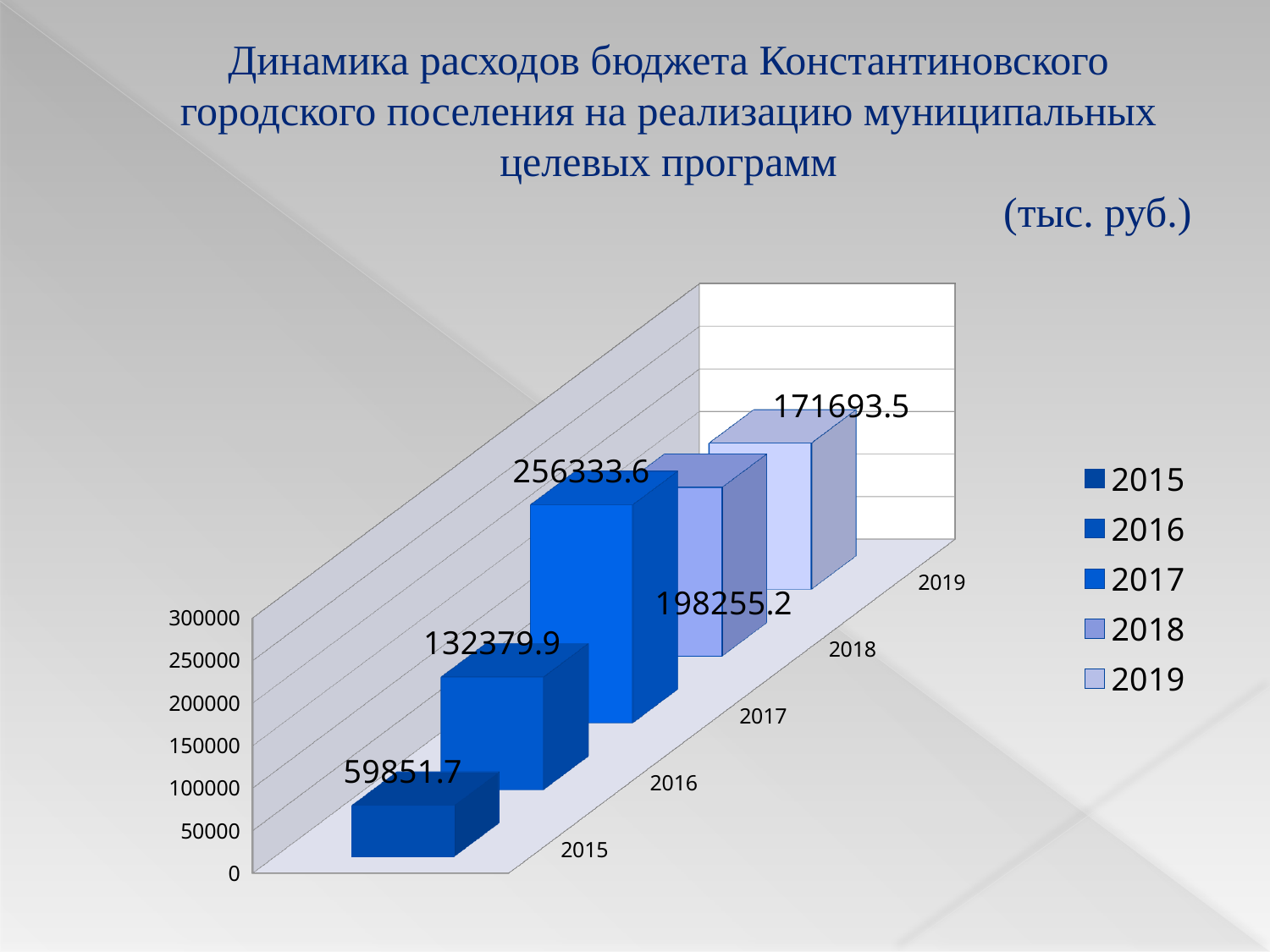
How many entries does the legend list? 5 What is the difference between the values for 2017 and 2018? 58078.4 What is the value for 2019? 171693.5 Do the values rise or fall from 2017 to 2019? fall How many years are shown on the chart? 5 Which year has the lowest value? 2015 What is the difference between the values for 2016 and 2015? 72528.2 What kind of chart is shown on the slide? bar chart Which is larger, the value for 2018 or the value for 2019? 2018 Which year has the highest value? 2017 What is the value for 2017? 256333.6 What is the value for 2015? 59851.7